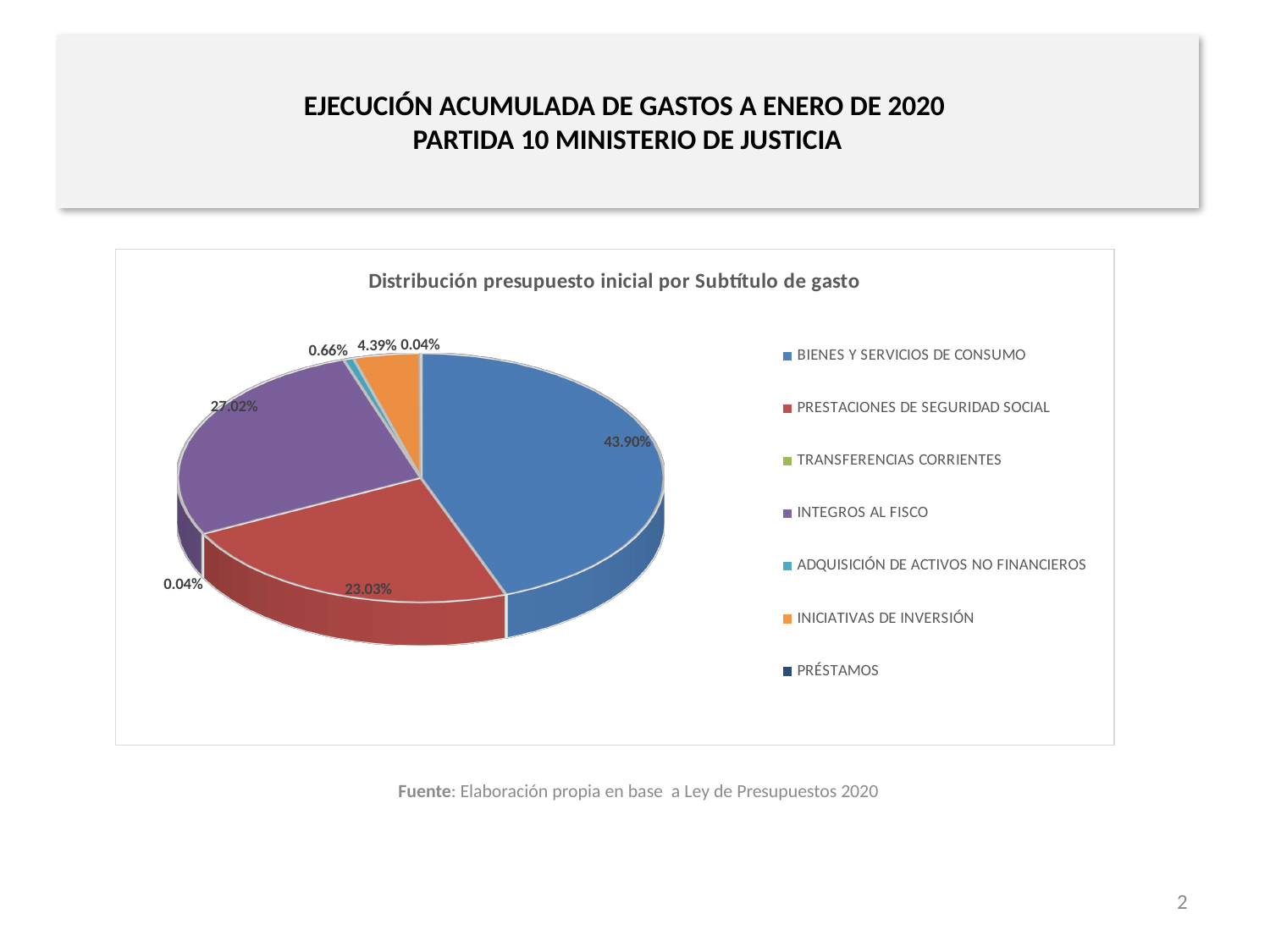
What share of the pie does BIENES Y SERVICIOS DE CONSUMO represent? 43.90% What is the difference in percentage points between INTEGROS AL FISCO and PRESTACIONES DE SEGURIDAD SOCIAL? 3.99 What percentage is shown for PRESTACIONES DE SEGURIDAD SOCIAL? 23.03% How many categories does the legend list? 7 What percentage is shown for INTEGROS AL FISCO? 27.02% What is the difference in percentage points between BIENES Y SERVICIOS DE CONSUMO and PRESTACIONES DE SEGURIDAD SOCIAL? 20.87 What is the title of the chart? Distribución presupuesto inicial por Subtítulo de gasto Which category has the largest share of the pie? BIENES Y SERVICIOS DE CONSUMO Which has a larger share, INTEGROS AL FISCO or PRESTACIONES DE SEGURIDAD SOCIAL? INTEGROS AL FISCO What percentage is shown for ADQUISICIÓN DE ACTIVOS NO FINANCIEROS? 0.66% What percentage is shown for INICIATIVAS DE INVERSIÓN? 4.39% What kind of chart is shown on the slide? Pie chart